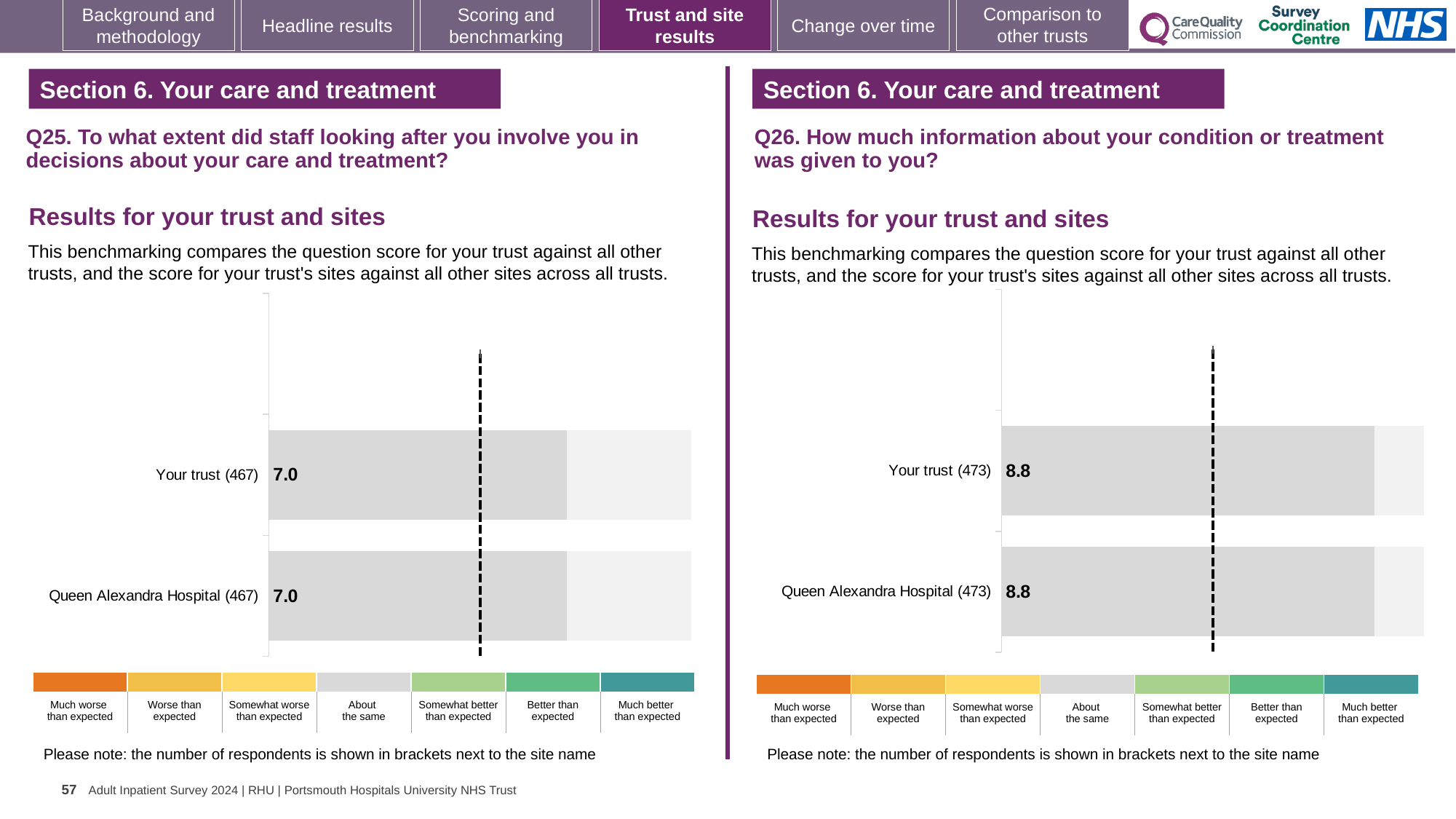
On the Q25 chart (left), what is the difference between the score for Your trust and the score for Queen Alexandra Hospital? 0.0 On the Q25 chart (left), what is the score for Queen Alexandra Hospital? 7.0 On the Q26 chart (right), how many bars are plotted? 2 Is the score for Your trust on the Q26 chart (right) larger or smaller than the score for Your trust on the Q25 chart (left)? Larger What kind of chart is the Q25 chart (left)? Bar chart On the Q25 chart (left), how many respondents are shown in brackets for Your trust? 467 On the Q26 chart (right), what is the score for Queen Alexandra Hospital? 8.8 On the Q26 chart (right), what is the score for Your trust? 8.8 On the Q26 chart (right), how many respondents are shown in brackets for Queen Alexandra Hospital? 473 How many categories does the colour key below the Q25 chart (left) list? 7 On the Q25 chart (left), what is the score for Your trust? 7.0 What is the label of the rightmost category in the colour key below the Q26 chart (right)? Much better than expected